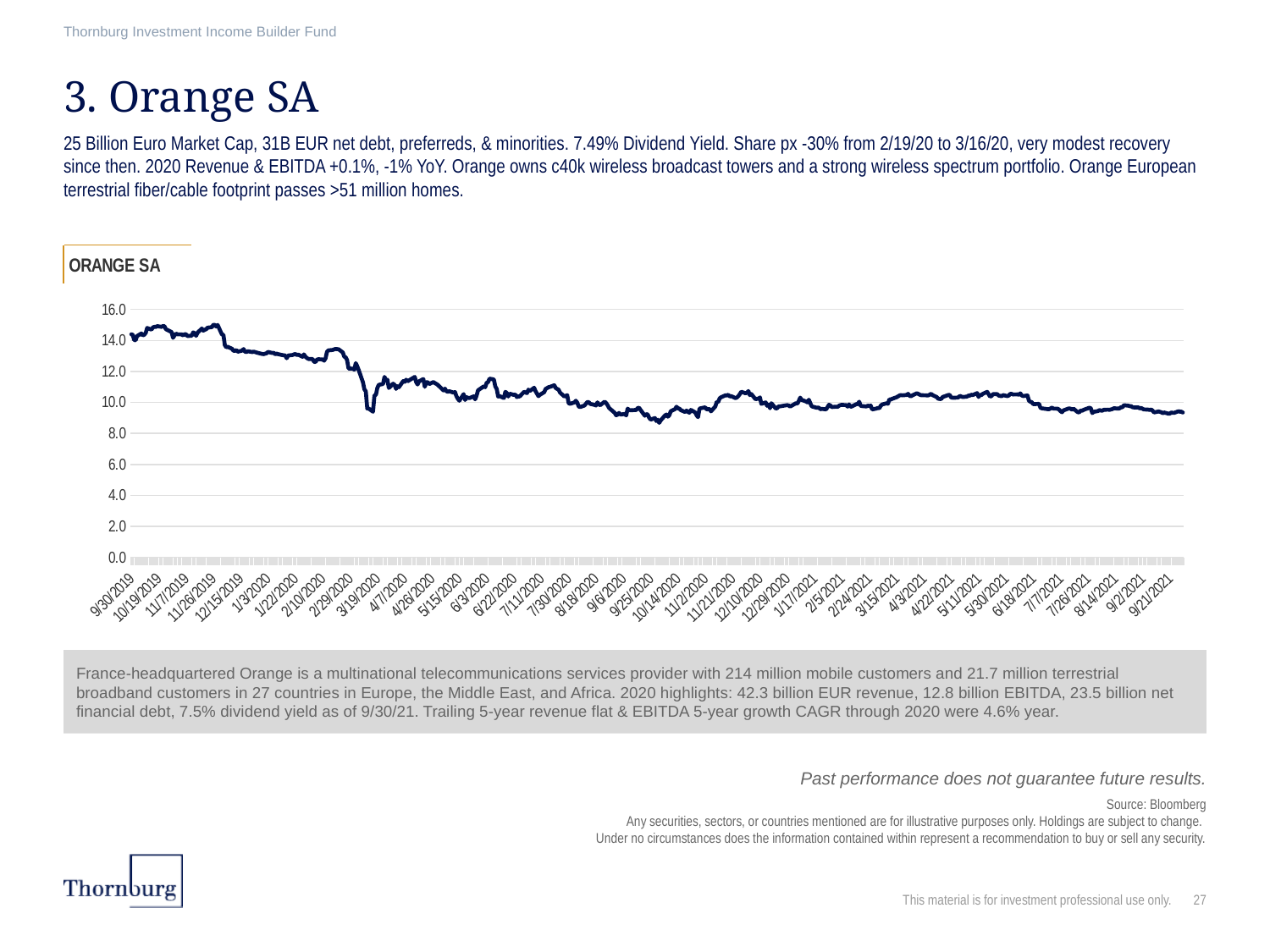
Is the value at 9/21/2021 greater or less than 10.0? less What is the highest value shown on the y-axis? 16.0 Is the value at 12/15/2019 greater or less than 12.0? greater Is the value at 10/14/2020 greater or less than 10.0? less What is the first date label on the x-axis? 9/30/2019 What is the title of the chart? ORANGE SA What is the last date label on the x-axis? 9/21/2021 Which is larger, the value at 9/30/2019 or the value at 9/21/2021? 9/30/2019 What kind of chart is shown on the slide? line chart Overall, do the values in the chart rise or fall from 9/30/2019 to 9/21/2021? fall